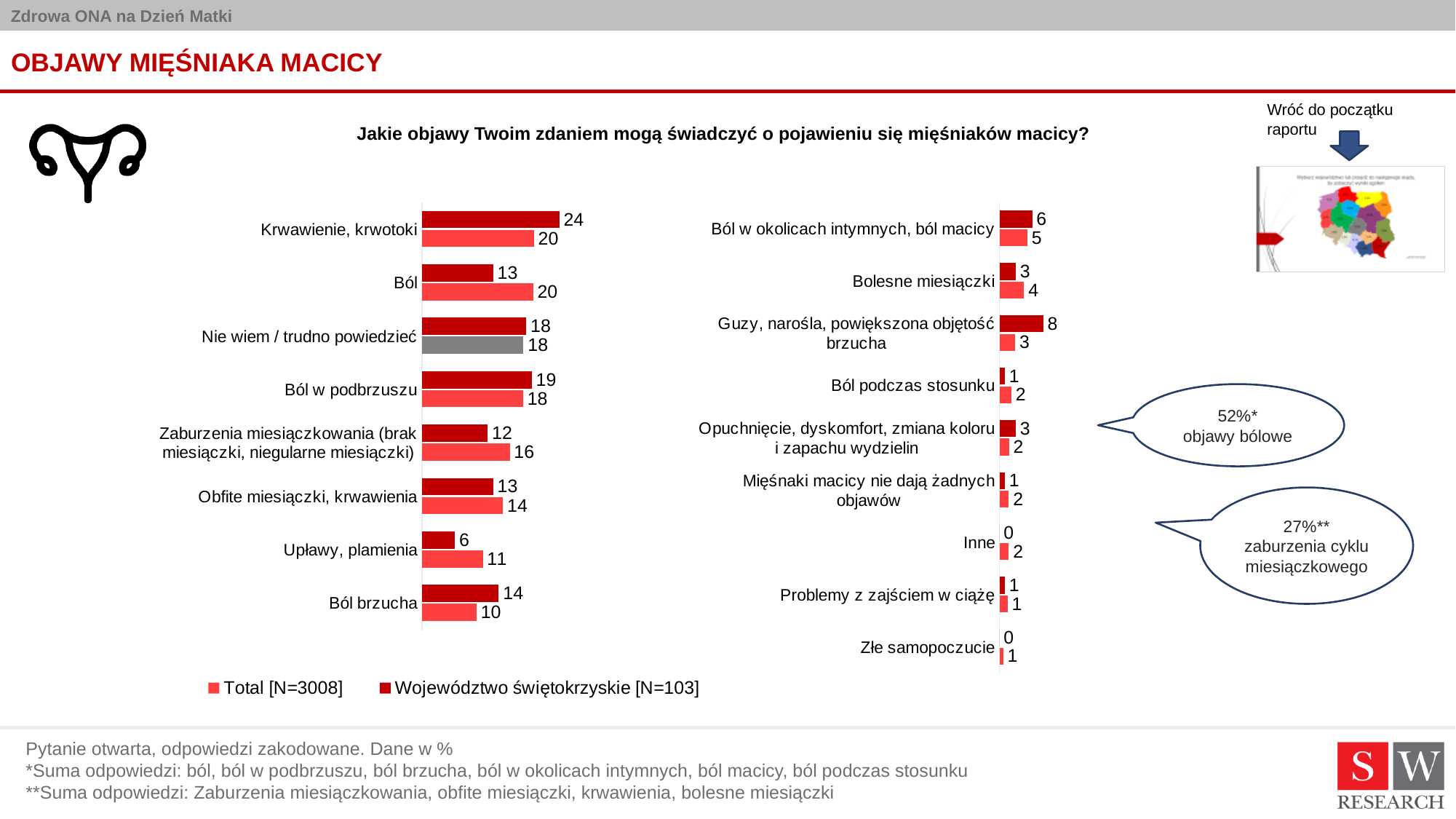
In the right chart, what is the Województwo świętokrzyskie [N=103] value for Guzy, narośla, powiększona objętość brzucha? 8 In the right chart, which is larger for Bolesne miesiączki: the Total [N=3008] value or the Województwo świętokrzyskie [N=103] value? Total [N=3008] What is the question shown as the title above the charts? Jakie objawy Twoim zdaniem mogą świadczyć o pojawieniu się mięśniaków macicy? In the left chart, which category has the highest Województwo świętokrzyskie [N=103] value? Krwawienie, krwotoki How many series does the legend list? 2 In the left chart, what is the difference between the Total [N=3008] and Województwo świętokrzyskie [N=103] values for Ból? 7 In the left chart, which category has the lowest Total [N=3008] value? Ból brzucha How many categories are shown in the left chart? 8 What type of chart is the left chart? Bar chart In the left chart, what is the Total [N=3008] value for Krwawienie, krwotoki? 20 In the left chart, what is the Województwo świętokrzyskie [N=103] value for Upławy, plamienia? 6 How many categories are shown in the right chart? 9